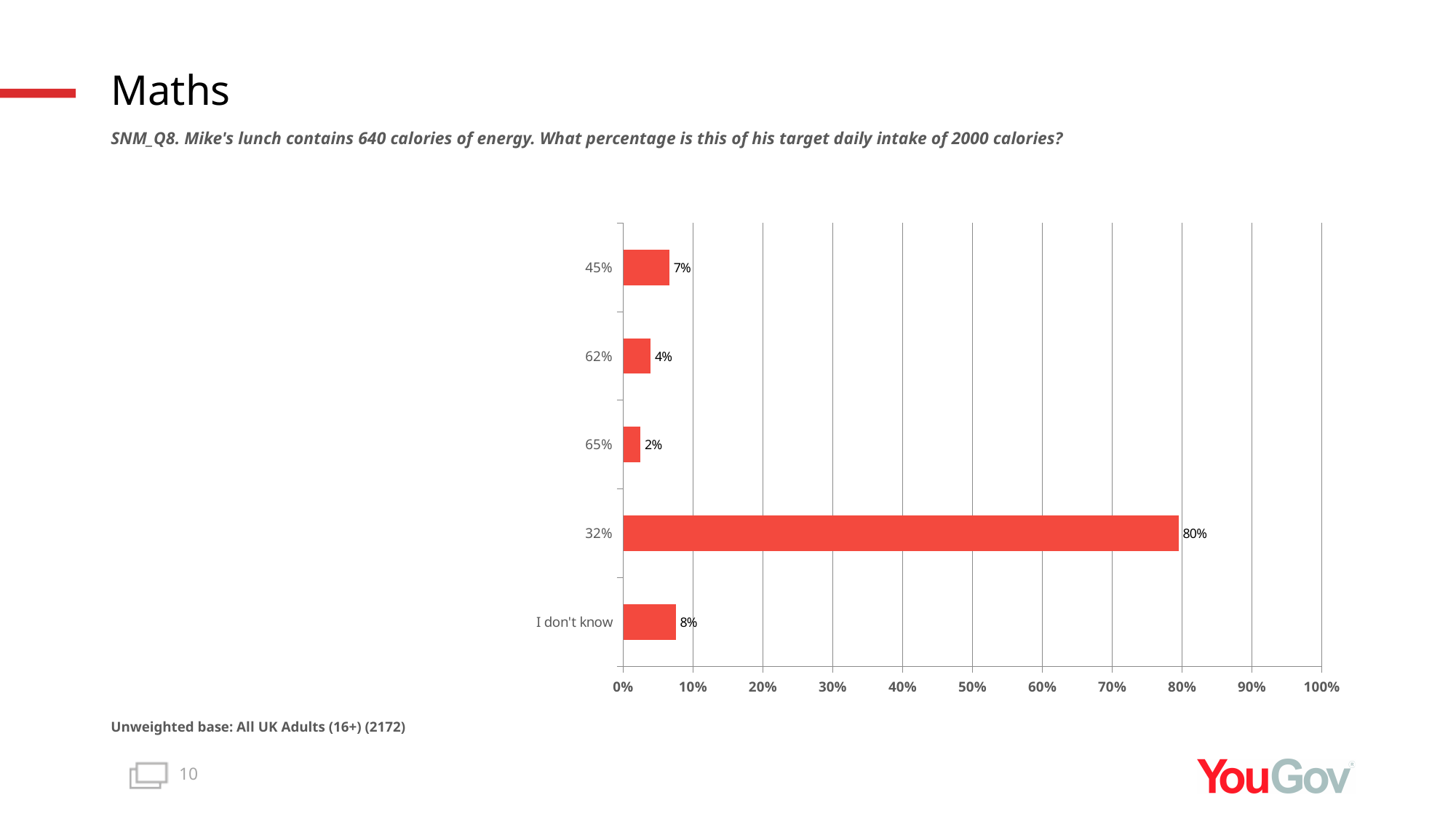
Which answer option has the lowest share of respondents? 65% Which has a larger share of respondents: the answer "62%" or the answer "45%"? 45% What percentage of respondents answered "65%"? 2% What percentage of respondents answered "I don't know"? 8% What is the difference between the share of respondents who answered "32%" and those who answered "I don't know"? 72% How many answer options are shown in the chart? 5 Is the value for the answer "32%" greater or less than 70%? greater What percentage of respondents answered "32%"? 80% Which answer option has the highest share of respondents? 32% What kind of chart is shown on the slide? bar chart What percentage of respondents answered "45%"? 7% What is the highest value shown on the x axis of the chart? 100%